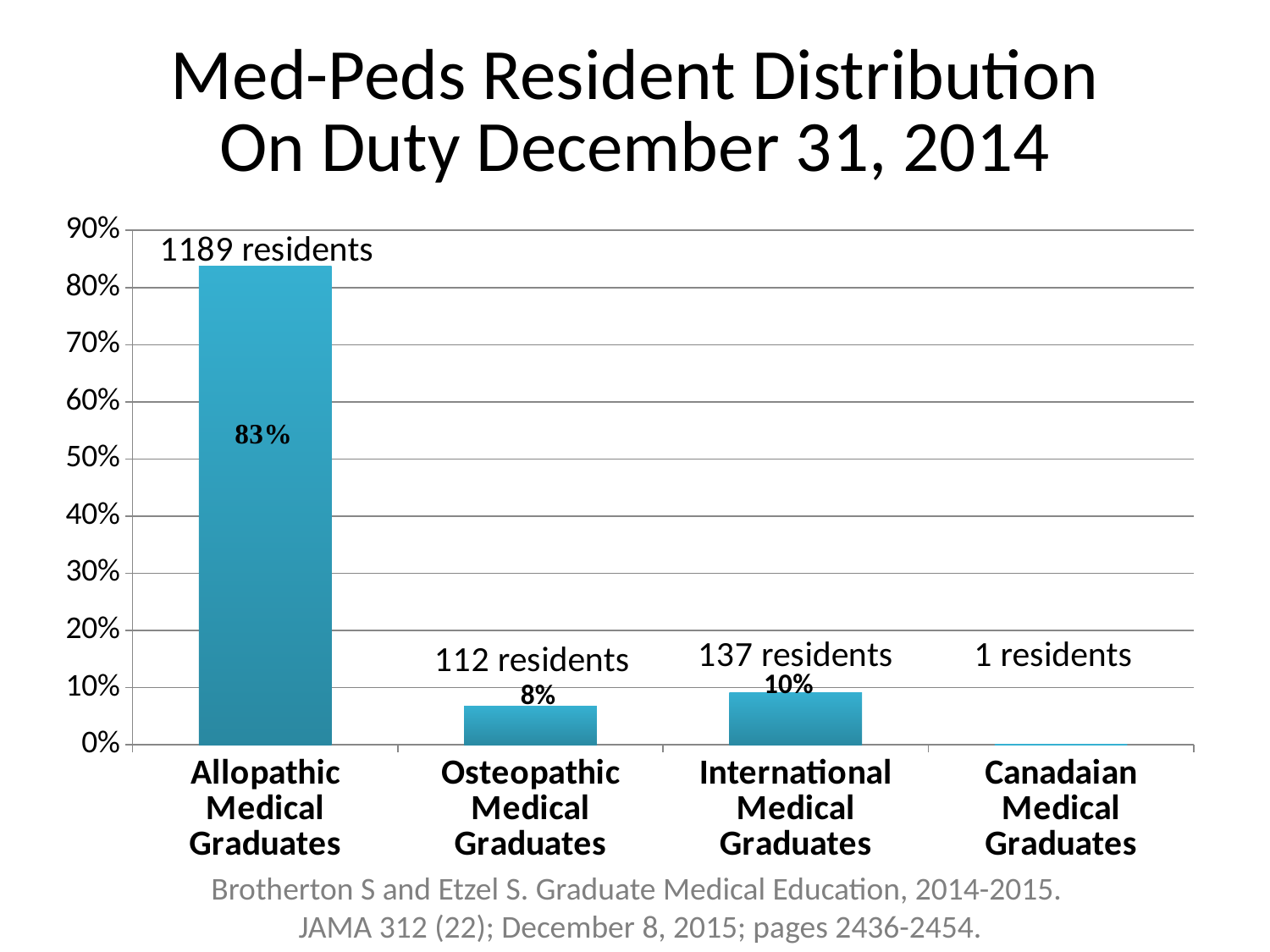
How many residents are labeled for International Medical Graduates? 137 residents What percentage is shown for International Medical Graduates? 10% How many residents are labeled for Osteopathic Medical Graduates? 112 residents How many residents are labeled for Canadaian Medical Graduates? 1 residents Which has more residents, International Medical Graduates or Osteopathic Medical Graduates? International Medical Graduates Which category has the lowest value? Canadaian Medical Graduates Is the value for Allopathic Medical Graduates greater or less than 80%? greater Which category has the highest value? Allopathic Medical Graduates What percentage is shown for Allopathic Medical Graduates? 83% What type of chart is this? Bar chart What is the difference in residents between Allopathic Medical Graduates and International Medical Graduates? 1052 How many categories are shown on the x axis? 4